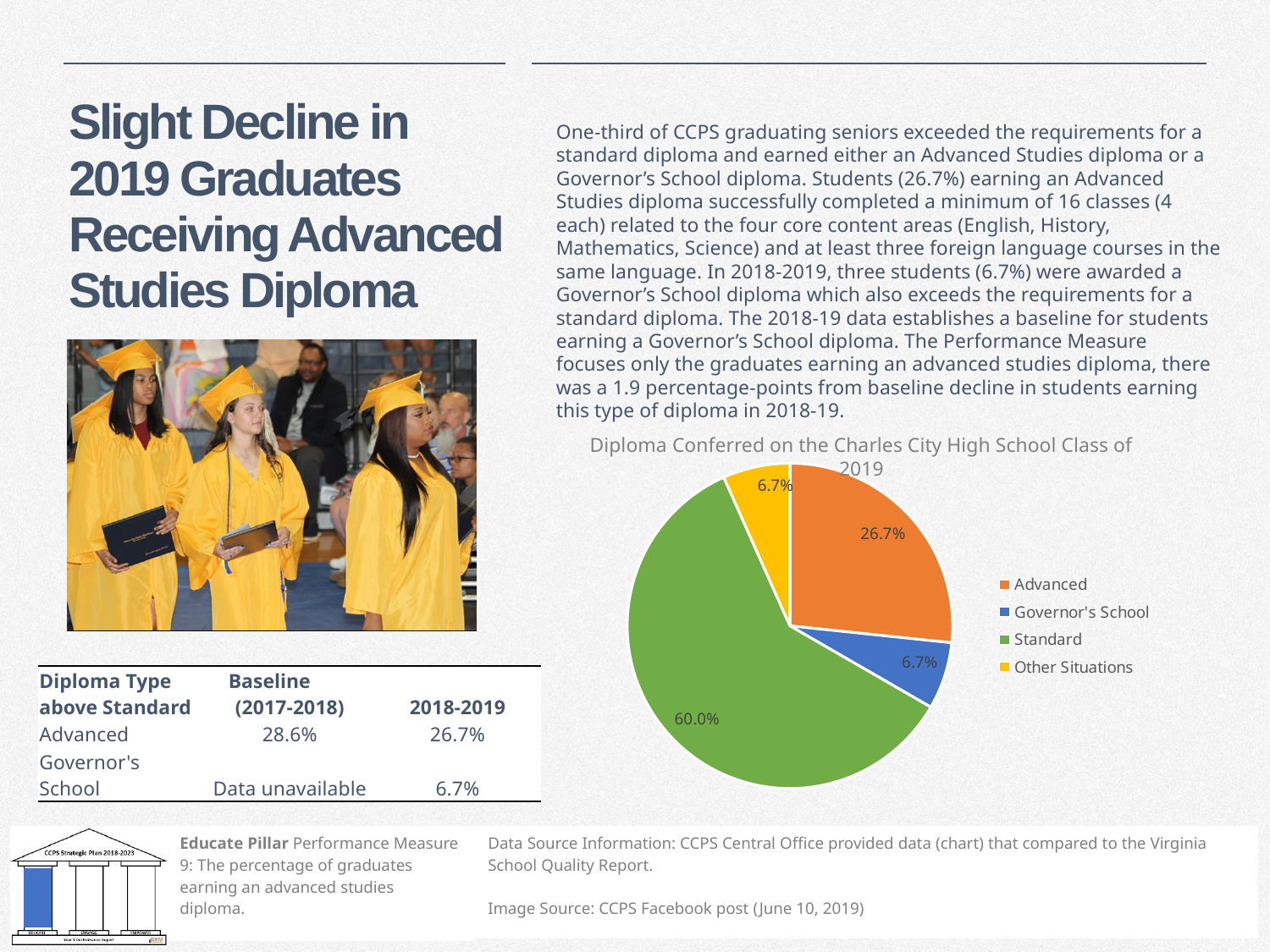
What share of the pie is the Governor's School slice? 6.7% What colour is the Standard slice in the pie chart? green What share of the pie is the Advanced slice? 26.7% What is the title of the chart? Diploma Conferred on the Charles City High School Class of 2019 How many categories does the legend list? 4 What type of chart is shown on the slide? pie chart What is the combined share of the Advanced and Governor's School slices? 33.4% What share of the pie is the Other Situations slice? 6.7% Which category has the largest slice of the pie? Standard What is the difference between the Standard share and the Advanced share? 33.3% Which is larger, the Advanced slice or the Governor's School slice? Advanced